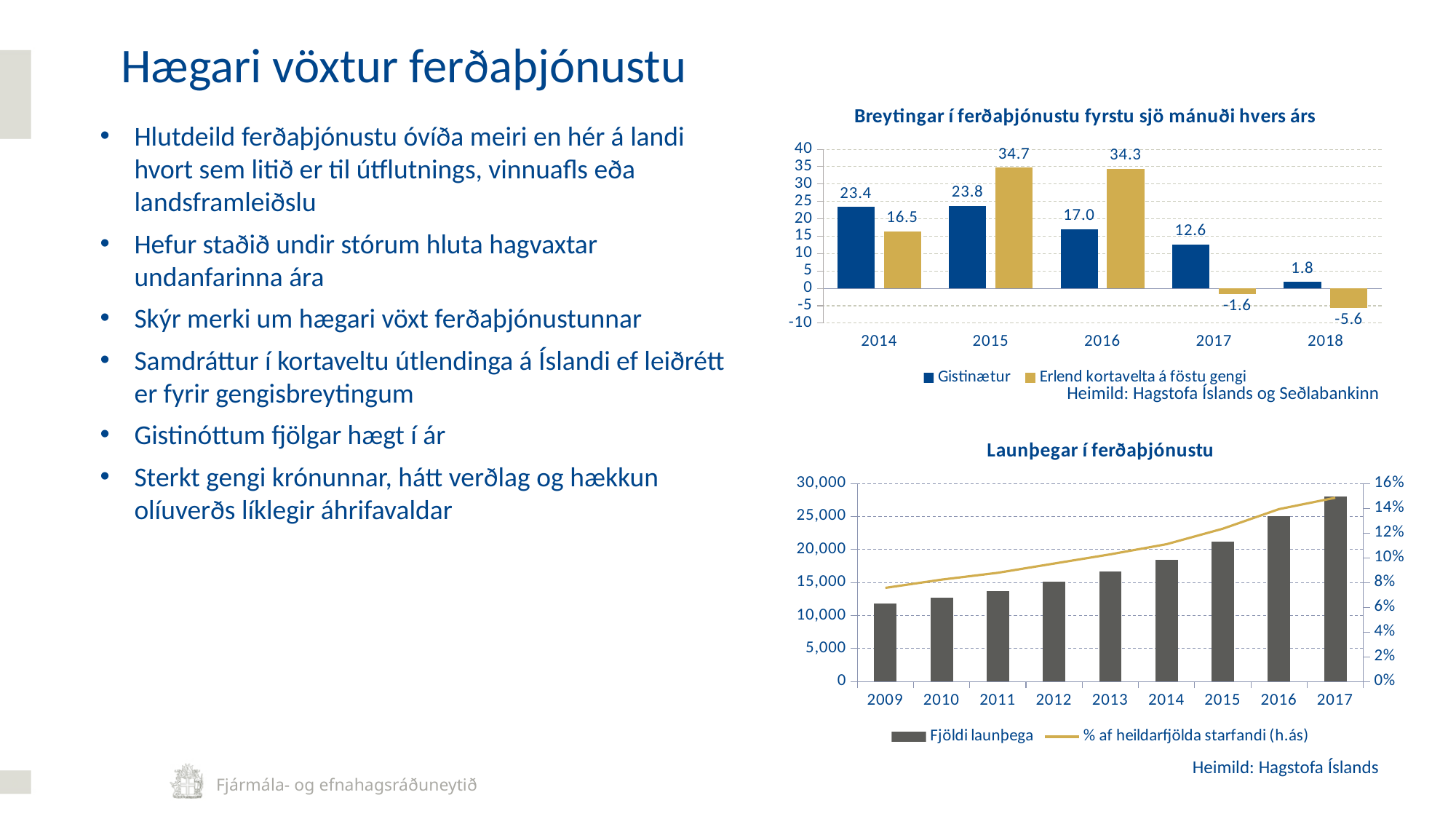
In the chart titled 'Launþegar í ferðaþjónustu', how many years are shown on the x axis? 9 In the chart titled 'Breytingar í ferðaþjónustu fyrstu sjö mánuði hvers árs', how many series does the legend list? 2 In the chart titled 'Launþegar í ferðaþjónustu', is the value for Fjöldi launþega in 2017 greater or less than 25,000? greater In the chart titled 'Launþegar í ferðaþjónustu', is the value for Fjöldi launþega in 2009 greater or less than 15,000? less In the chart titled 'Breytingar í ferðaþjónustu fyrstu sjö mánuði hvers árs', what is the value for Gistinætur in 2016? 17.0 In the chart titled 'Breytingar í ferðaþjónustu fyrstu sjö mánuði hvers árs', which year has the highest value for Erlend kortavelta á föstu gengi? 2015 In the chart titled 'Breytingar í ferðaþjónustu fyrstu sjö mánuði hvers árs', how many years are shown on the x axis? 5 In the chart titled 'Breytingar í ferðaþjónustu fyrstu sjö mánuði hvers árs', what is the difference between the Gistinætur values for 2014 and 2017? 10.8 In the chart titled 'Breytingar í ferðaþjónustu fyrstu sjö mánuði hvers árs', which is larger in 2014: Gistinætur or Erlend kortavelta á föstu gengi? Gistinætur In the chart titled 'Breytingar í ferðaþjónustu fyrstu sjö mánuði hvers árs', which year has the lowest value for Gistinætur? 2018 In the chart titled 'Breytingar í ferðaþjónustu fyrstu sjö mánuði hvers árs', what is the value for Erlend kortavelta á föstu gengi in 2018? -5.6 In the chart titled 'Launþegar í ferðaþjónustu', do the Fjöldi launþega bars rise or fall from 2009 to 2017? rise